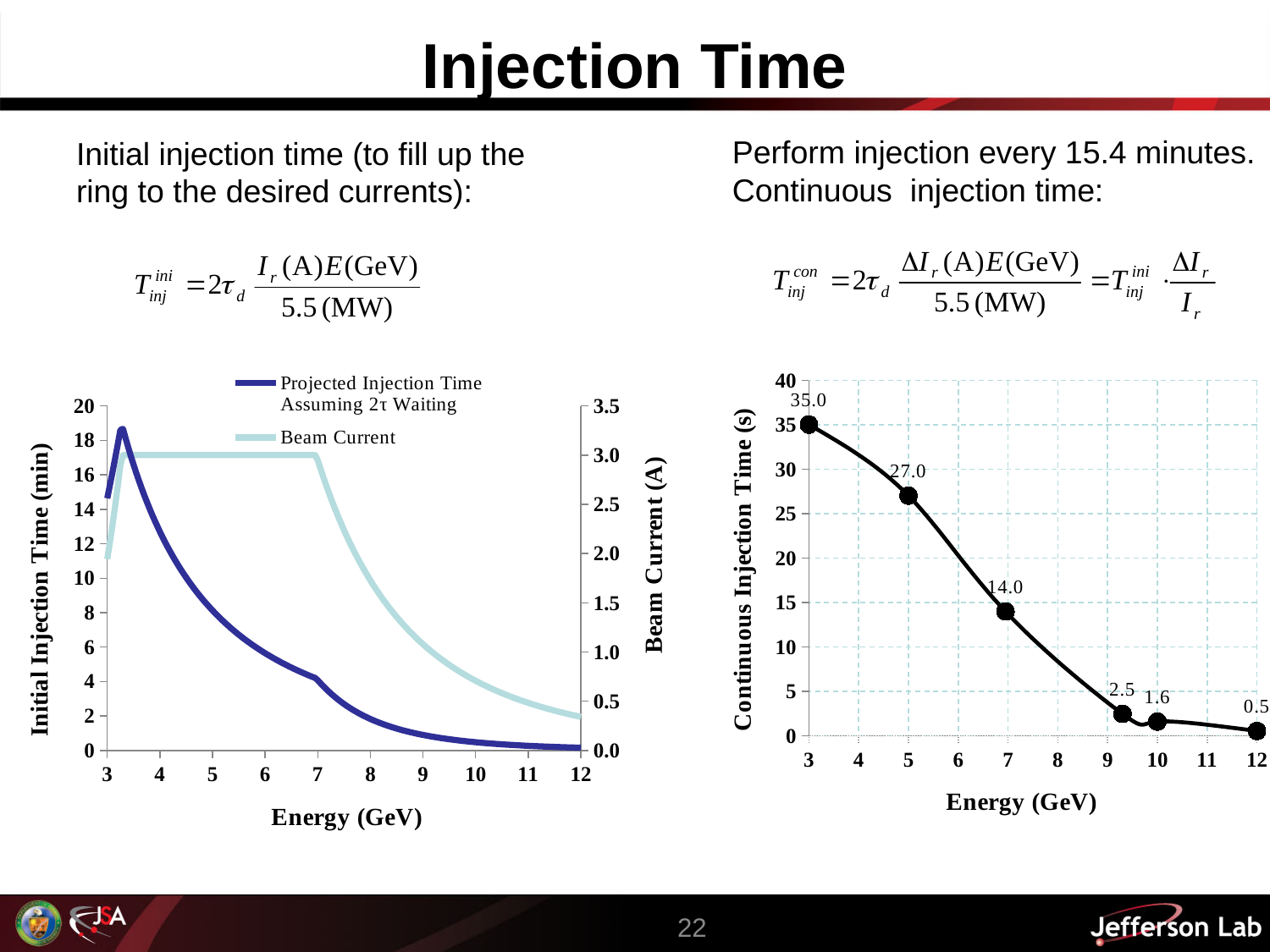
On the left chart (Initial Injection Time), is the beam current at 5 GeV greater or less than 2.5 A? greater On the right chart (Continuous Injection Time), what is the continuous injection time at 10 GeV? 1.6 What kind of chart is the right chart (Continuous Injection Time)? line chart On the right chart (Continuous Injection Time), does the continuous injection time rise or fall as energy increases? fall On the left chart (Initial Injection Time), is the projected injection time at 12 GeV greater or less than 2 min? less On the right chart (Continuous Injection Time), at which energy is the continuous injection time highest? 3 GeV On the right chart (Continuous Injection Time), what is the difference between the continuous injection time at 3 GeV and at 5 GeV? 8.0 On the left chart (Initial Injection Time), how many series does the legend list? 2 On the right chart (Continuous Injection Time), what is the continuous injection time at 3 GeV? 35.0 On the right chart (Continuous Injection Time), how many data points are plotted? 6 On the right chart (Continuous Injection Time), what is the continuous injection time at 7 GeV? 14.0 On the right chart (Continuous Injection Time), what is the continuous injection time at 12 GeV? 0.5